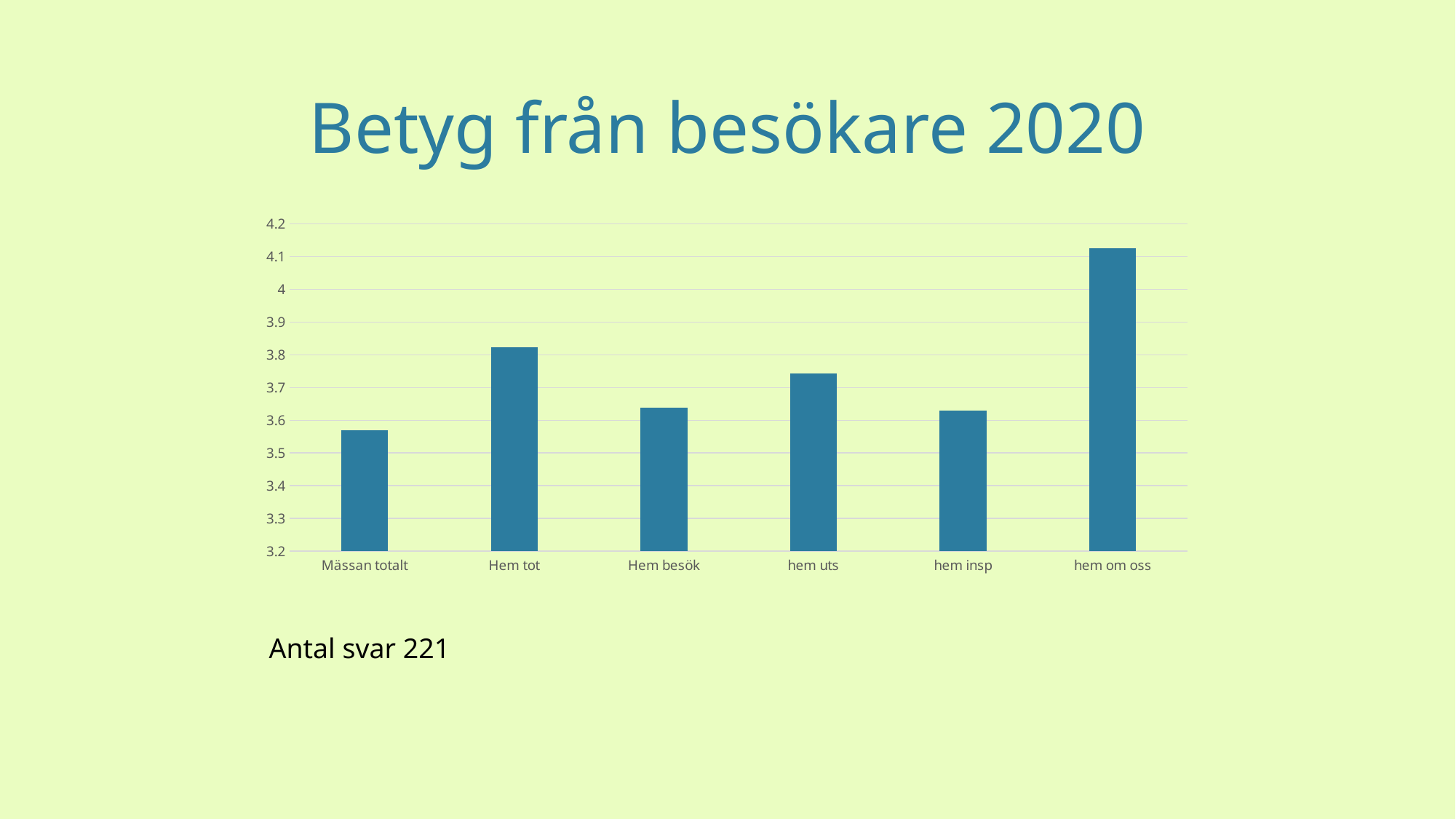
Which category has the lowest value in the chart? Mässan totalt How many categories are shown on the x axis of the chart? 6 What kind of chart is shown on the slide? bar chart Is the value for hem om oss greater or less than 4? greater Which is larger, the value for Hem tot or the value for hem uts? Hem tot Which category has the highest value in the chart? hem om oss Which is larger, the value for hem insp or the value for hem om oss? hem om oss Is the value for Mässan totalt greater or less than 3.6? less What is the number of responses (Antal svar) stated below the chart? 221 Is the value for Hem tot greater or less than 3.8? greater What is the title of the chart on the slide? Betyg från besökare 2020